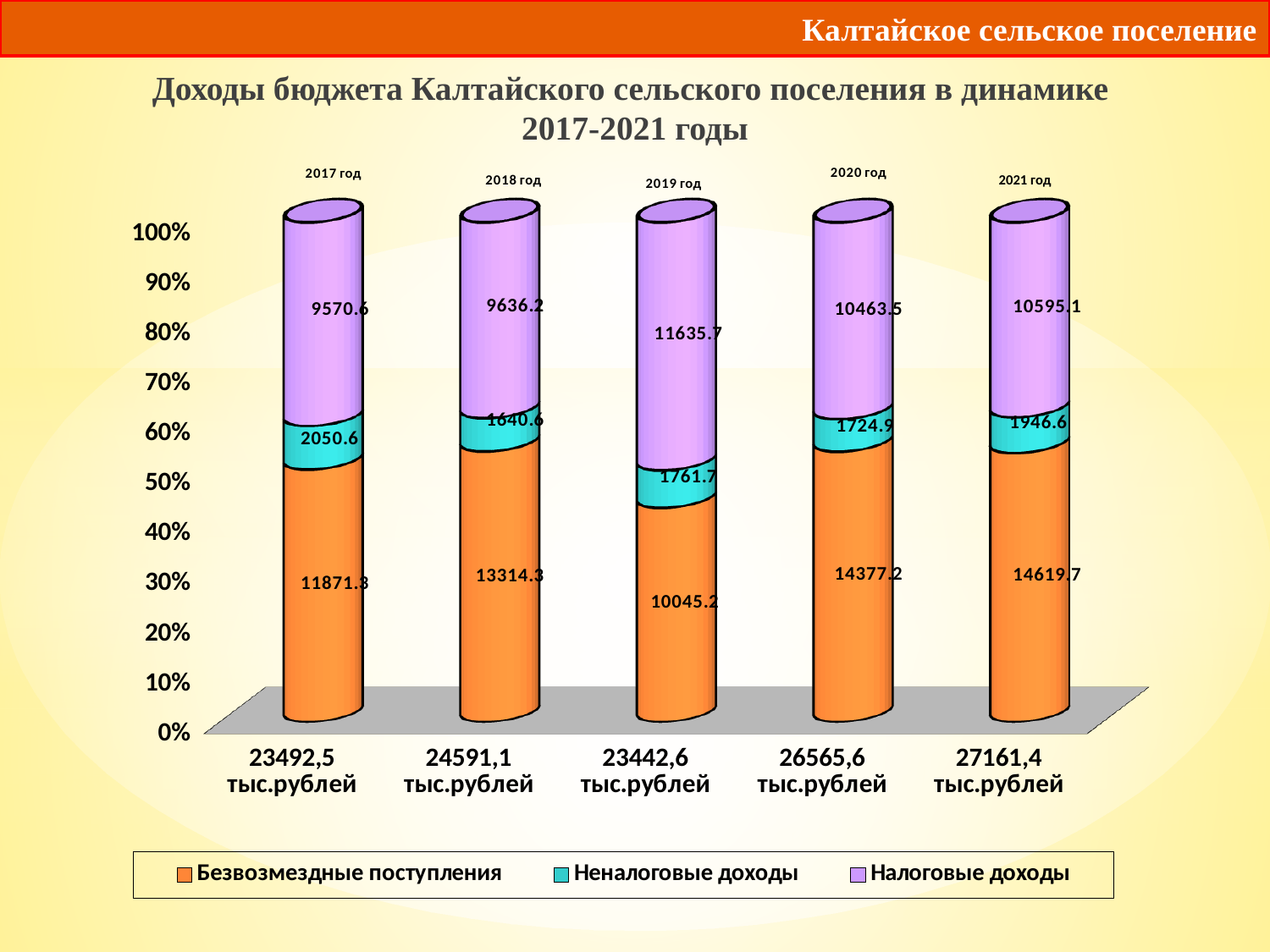
What is the total budget income shown for 2020 год? 26565,6 тыс.рублей What is the difference between Безвозмездные поступления in 2021 год and in 2017 год? 2748.4 How many years (bars) are shown in the chart? 5 What kind of chart is shown on the slide? Stacked bar chart Which year has the larger value of Налоговые доходы, 2020 год or 2021 год? 2021 год Which series is shown in orange in the legend? Безвозмездные поступления In which year is the value of Неналоговые доходы the lowest? 2018 год What is the value of Неналоговые доходы for 2017 год? 2050.6 In which year is the value of Налоговые доходы the highest? 2019 год What is the value of Налоговые доходы for 2019 год? 11635.7 What is the value of Безвозмездные поступления for 2021 год? 14619.7 How many series does the legend list? 3